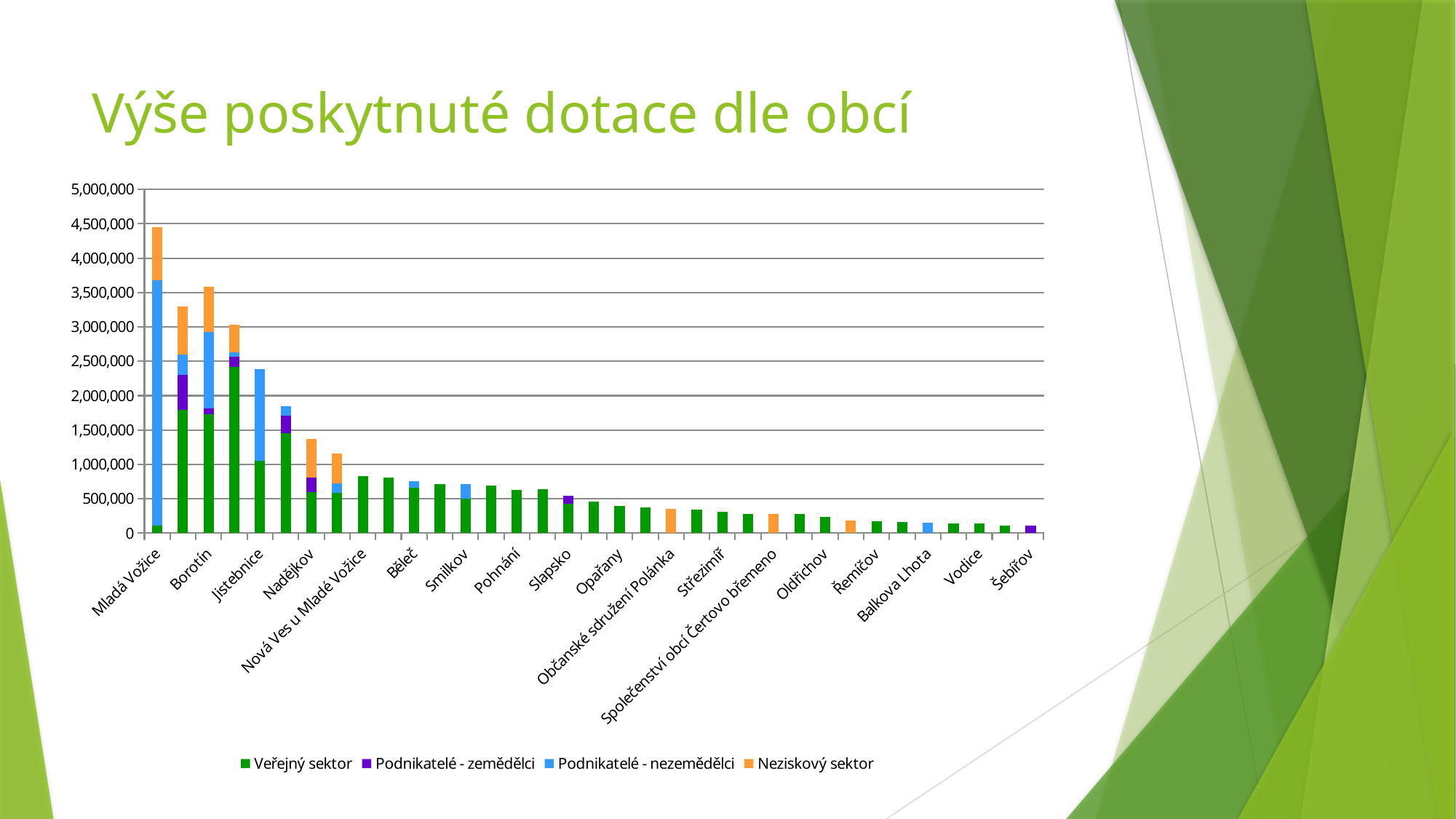
Which has a larger total subsidy, Mladá Vožice or Borotín? Mladá Vožice Is the total value for Borotín greater or less than 3,000,000? greater What kind of chart is shown on the slide? Stacked bar chart Which municipality has the highest total subsidy in the chart? Mladá Vožice What is the title of the chart? Výše poskytnuté dotace dle obcí How many series does the legend list? 4 Is the total value for Mladá Vožice greater or less than 4,000,000? greater Which has a larger total subsidy, Nadějkov or Běleč? Nadějkov Do the total values generally rise or fall from left to right along the x axis? fall Is the total value for Nová Ves u Mladé Vožice greater or less than 1,000,000? less Which series makes up the largest part of the Mladá Vožice bar? Podnikatelé - nezemědělci